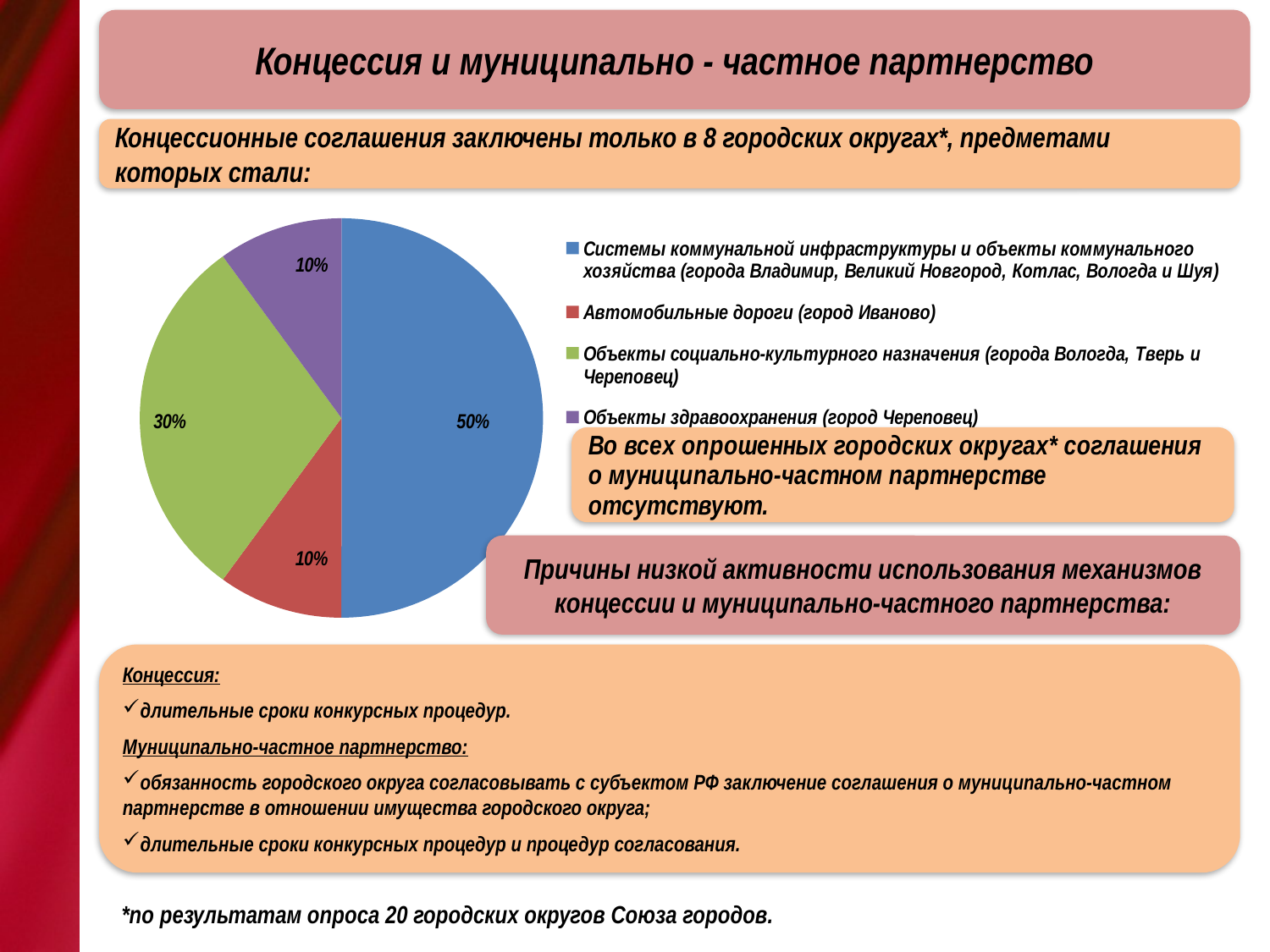
What colour is the slice for "Объекты здравоохранения (город Череповец)" in the pie chart? purple What share of the pie is labelled for "Системы коммунальной инфраструктуры и объекты коммунального хозяйства"? 50% What kind of chart is shown on the slide? pie chart What is the difference in percentage points between the slice for "Системы коммунальной инфраструктуры" and the slice for "Объекты социально-культурного назначения"? 20% How many entries does the legend of the pie chart list? 4 Which category has the largest slice of the pie chart? Системы коммунальной инфраструктуры и объекты коммунального хозяйства What share of the pie is labelled for "Автомобильные дороги (город Иваново)"? 10% How many slices does the pie chart have? 4 Which slice is larger: "Объекты социально-культурного назначения" or "Автомобильные дороги"? Объекты социально-культурного назначения What share of the pie is labelled for "Объекты здравоохранения (город Череповец)"? 10% What colour is the slice for "Автомобильные дороги (город Иваново)" in the pie chart? red What share of the pie is labelled for "Объекты социально-культурного назначения"? 30%